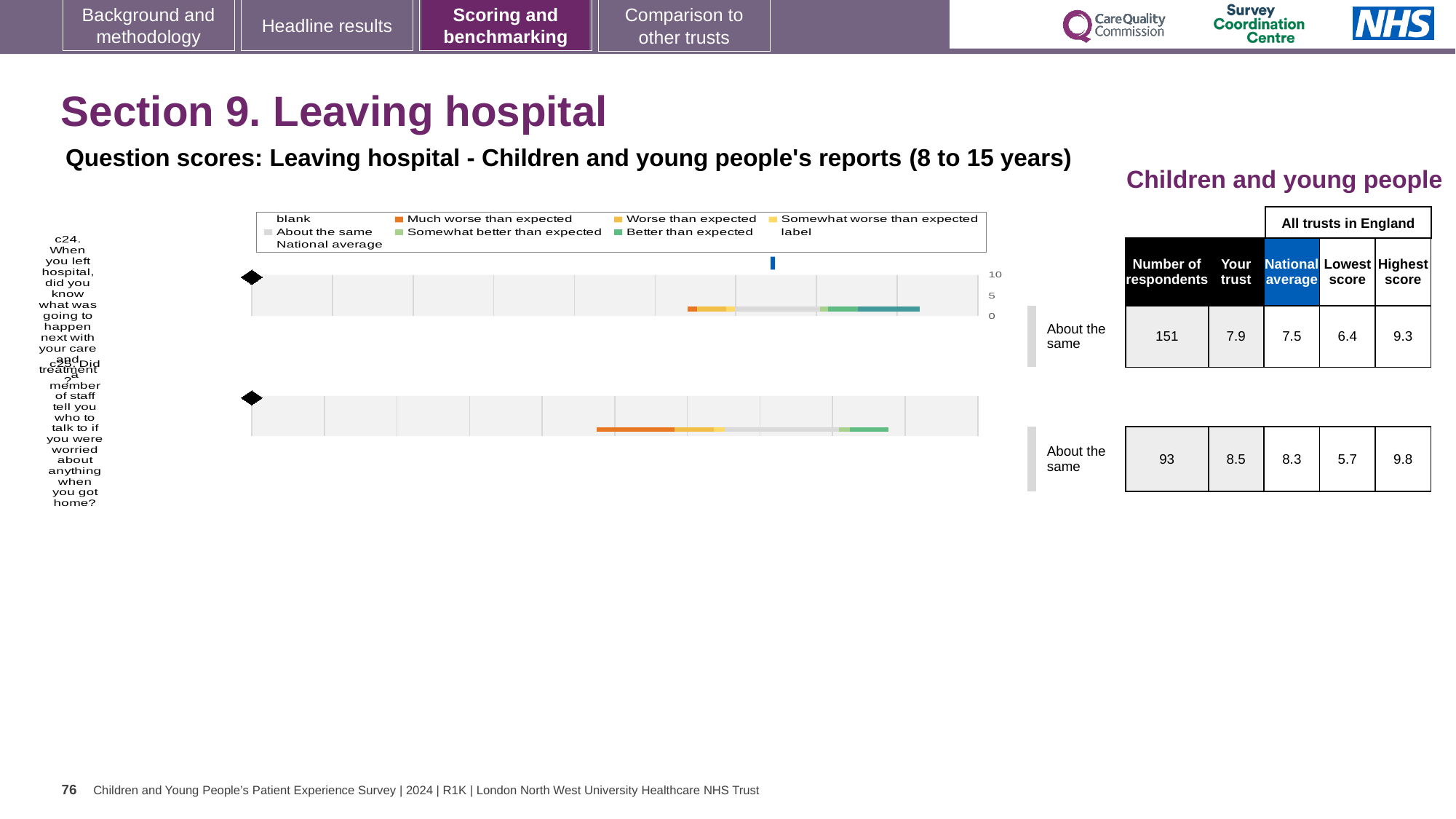
What is the 'Your trust' score for question c24 (When you left hospital, did you know what was going to happen next with your care and treatment?)? 7.9 By how much does the trust's score for question c25 (8.5) exceed the national average (8.3)? 0.2 What is the difference between the highest score (9.3) and the lowest score (6.4) for question c24? 2.9 What is the lowest score among all trusts in England for question c24? 6.4 What is the highest score among all trusts in England for question c25? 9.8 Which question had more respondents, c24 or c25? c24 Which question has the higher 'Your trust' score, c24 or c25? c25 How many questions are plotted on the chart? 2 What benchmark category is the trust's score for question c24 placed in? About the same What is the national average score for question c25 (Did a member of staff tell you who to talk to if you were worried about anything when you got home?)? 8.3 What kind of chart is used to show the question scores? Bar chart How many respondents answered question c24? 151